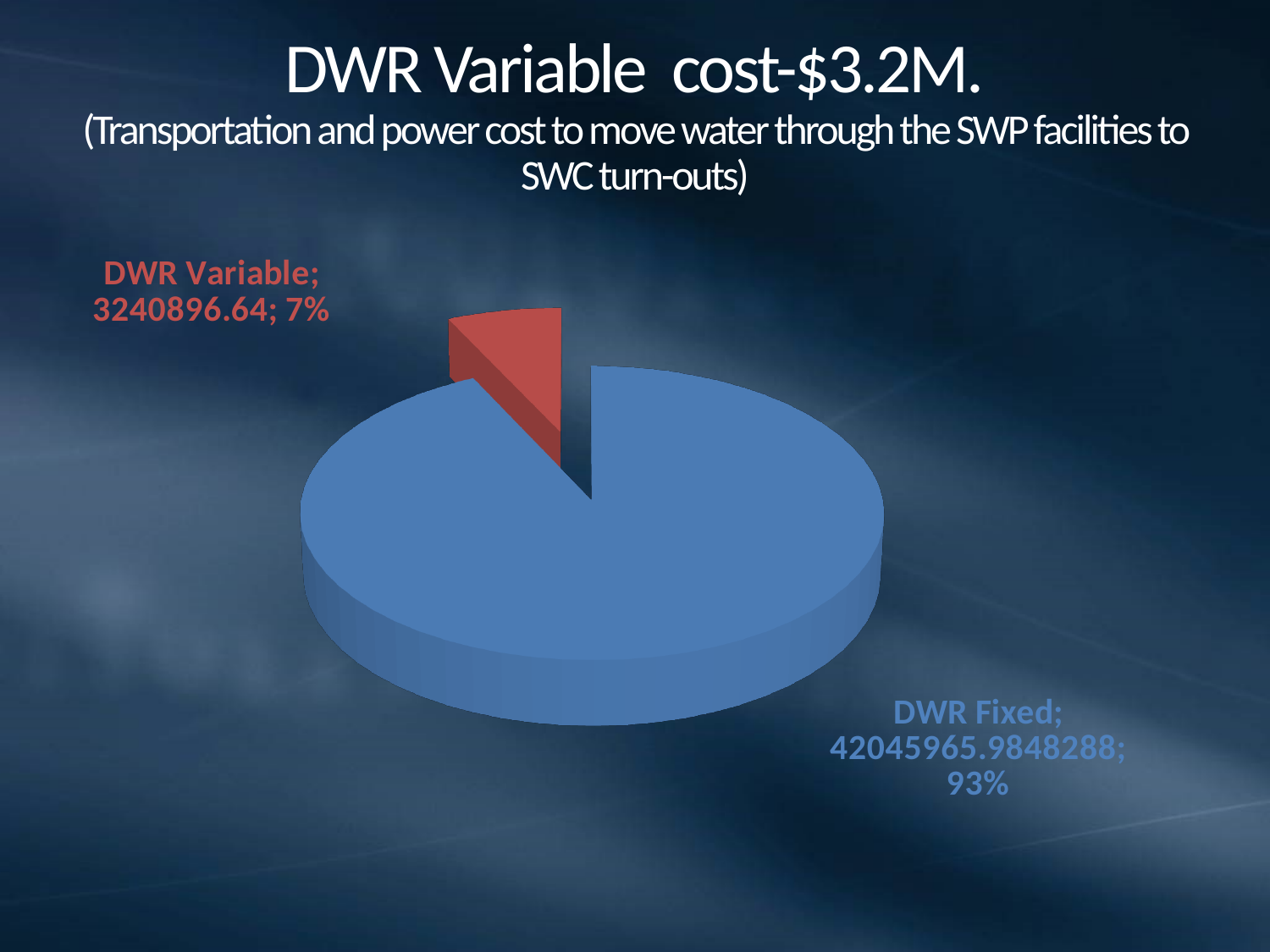
What share of the pie does DWR Fixed represent? 93% What is the value for DWR Variable? 3240896.64 What colour is the DWR Variable slice? red What is the title of the slide? DWR Variable cost-$3.2M. Which is larger, DWR Fixed or DWR Variable? DWR Fixed Which slice is the smallest? DWR Variable How many slices does the pie chart have? 2 Which slice is the largest? DWR Fixed What kind of chart is shown on the slide? pie chart What is the value for DWR Fixed? 42045965.9848288 What share of the pie does DWR Variable represent? 7%